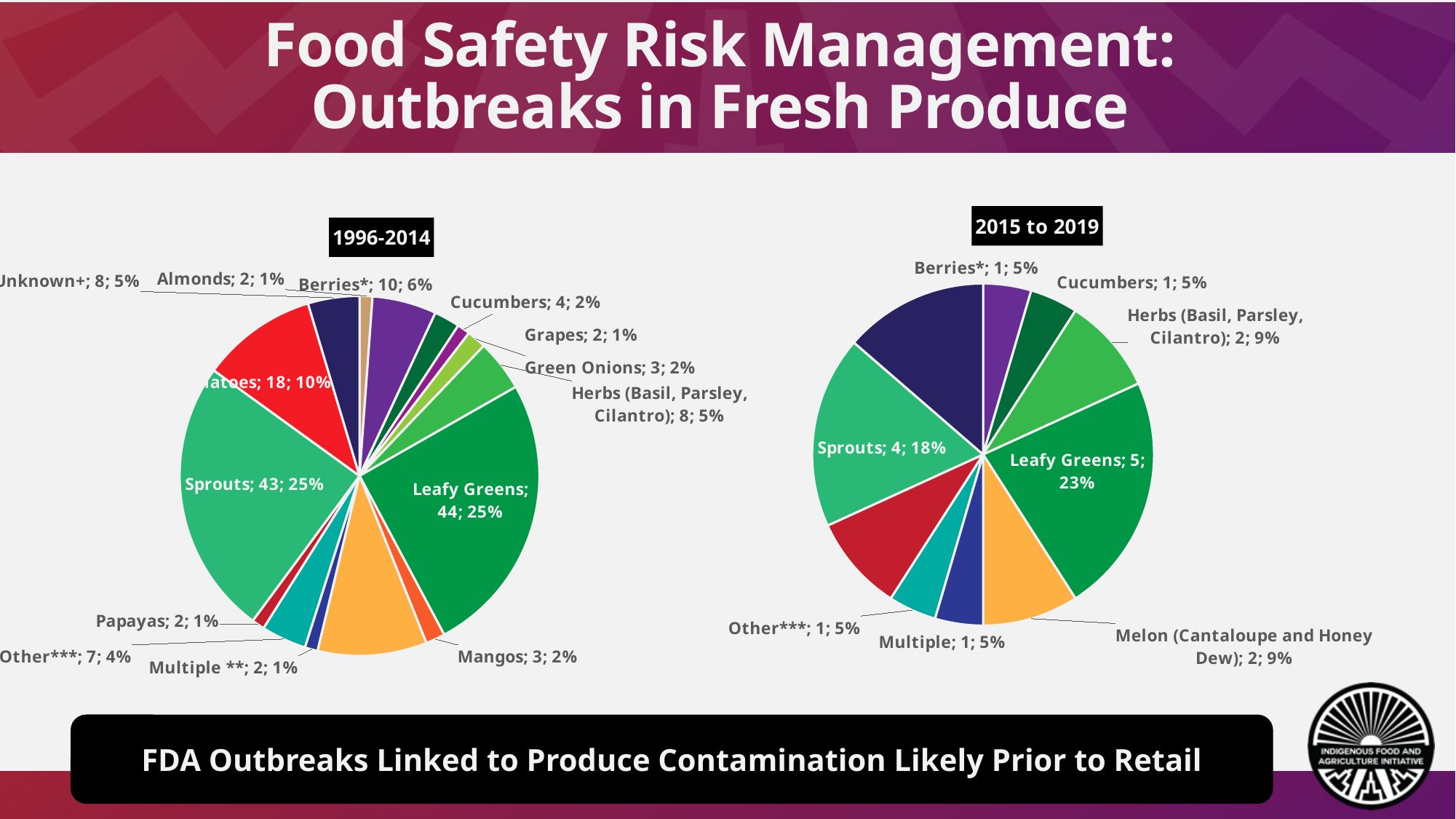
In the 1996-2014 pie chart, what share of outbreaks is attributed to Herbs (Basil, Parsley, Cilantro)? 5% In the 2015 to 2019 pie chart, what share of outbreaks is attributed to Melon (Cantaloupe and Honey Dew)? 9% In the 1996-2014 pie chart, which has more outbreaks, Cucumbers or Green Onions? Cucumbers In the 2015 to 2019 pie chart, which labeled category has the largest share of outbreaks? Leafy Greens In the 2015 to 2019 pie chart, how many outbreaks are attributed to Sprouts? 4 In the 1996-2014 pie chart, what is the difference in outbreak counts between Leafy Greens and Sprouts? 1 In the 1996-2014 pie chart, what share of outbreaks is attributed to Sprouts? 25% What type of chart is used for the 1996-2014 data? Pie chart In the 1996-2014 pie chart, how many outbreaks are attributed to Leafy Greens? 44 What is the title of the chart on the right side of the slide? 2015 to 2019 In the 1996-2014 pie chart, how many outbreaks are attributed to Berries*? 10 In the 2015 to 2019 pie chart, what is the difference in outbreak counts between Leafy Greens and Sprouts? 1